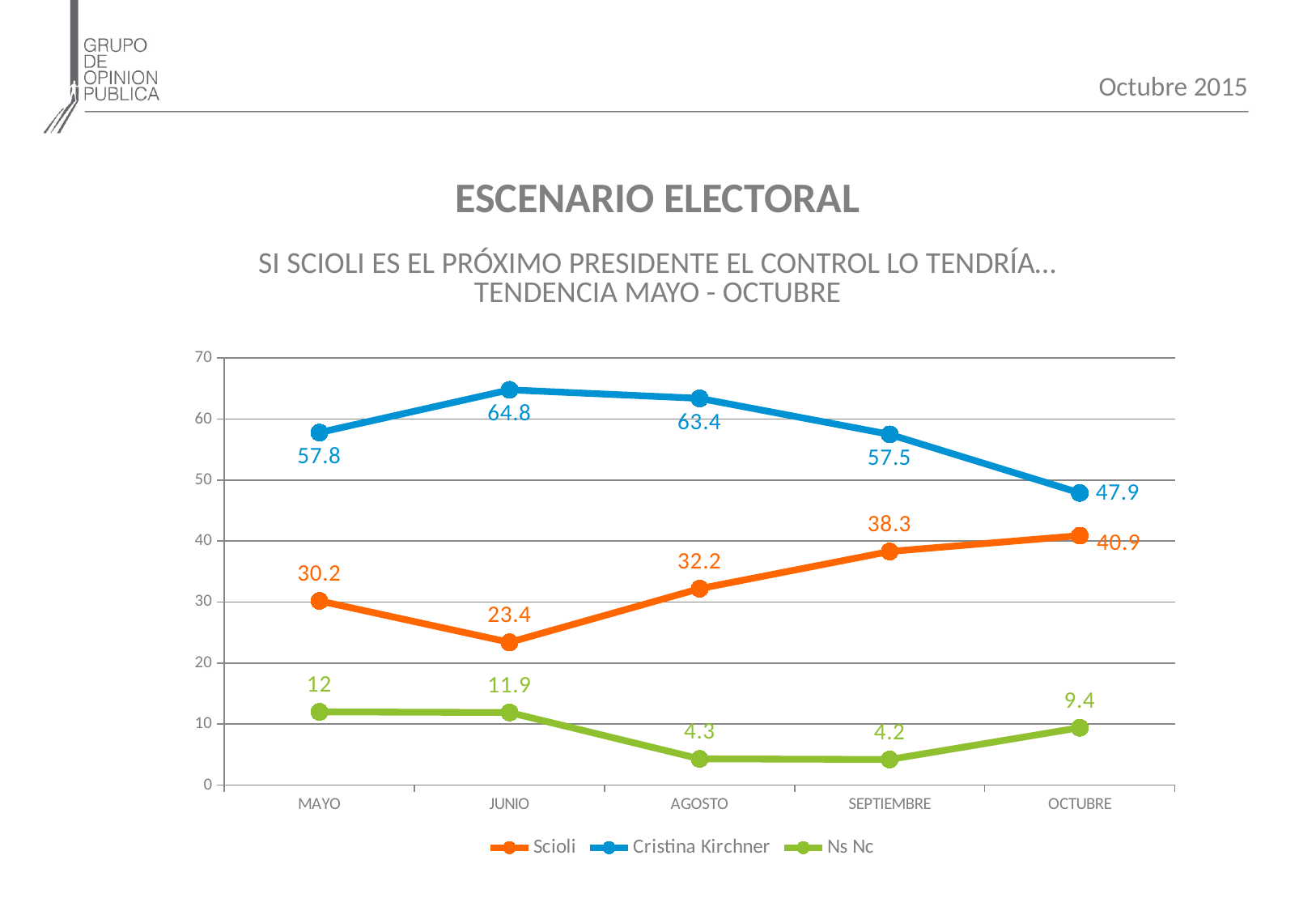
In which month is the Scioli series lowest? JUNIO What is the value for Scioli in SEPTIEMBRE? 38.3 How many series does the legend list? 3 What is the difference between Cristina Kirchner and Scioli in OCTUBRE? 7 In which month is the Cristina Kirchner series highest? JUNIO What kind of chart is shown on the slide? line chart Which is larger in MAYO: the value for Scioli or the value for Ns Nc? Scioli What is the value for Ns Nc in AGOSTO? 4.3 What is the value for Cristina Kirchner in JUNIO? 64.8 Is the value for Cristina Kirchner in SEPTIEMBRE greater or less than 50? greater How many months are shown on the x axis? 5 Does the Cristina Kirchner series rise or fall from JUNIO to OCTUBRE? fall